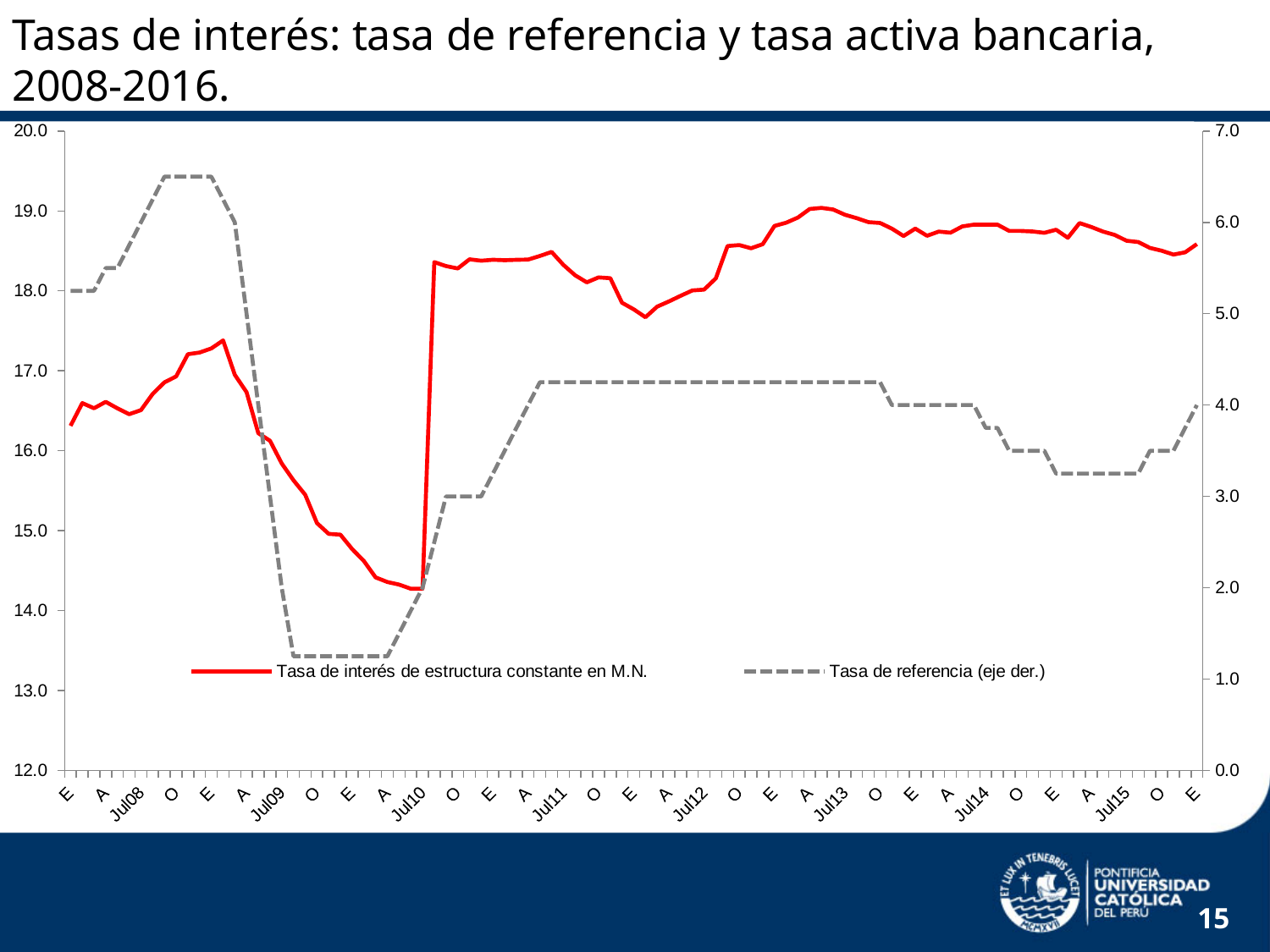
Does the 'Tasa de interés de estructura constante en M.N.' line rise or fall between Jul09 and Jul10? fall Is the value of 'Tasa de interés de estructura constante en M.N.' at Jul10 greater or less than 15.0? less Does the 'Tasa de referencia (eje der.)' line rise or fall between Jul10 and Jul11? rise How many series does the legend list? 2 What is the maximum value shown on the right-hand axis? 7.0 What kind of chart is shown on the slide? line chart Is the value of 'Tasa de interés de estructura constante en M.N.' at Jul13 greater or less than 18.0? greater Is the value of 'Tasa de referencia (eje der.)' at Jul12 greater or less than 3.0 on the right axis? greater Which series is drawn as a grey dashed line? Tasa de referencia (eje der.)